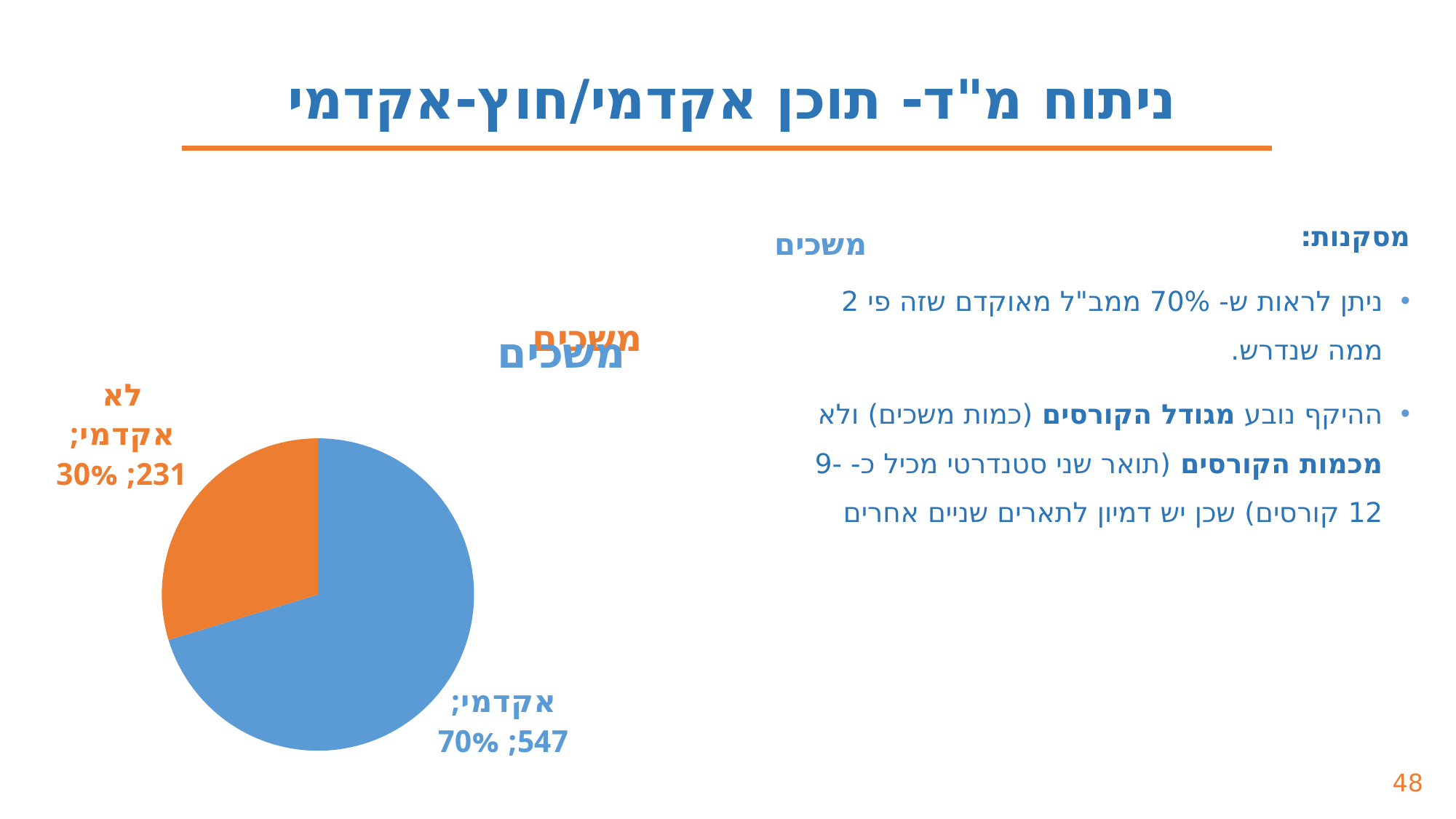
What value is shown for the לא אקדמי slice? 231 What is the difference between the אקדמי value and the לא אקדמי value? 316 What is the title of the pie chart? משכים How many slices does the pie chart have? 2 What share of the pie does the אקדמי slice represent? 70% Which is larger, the אקדמי slice or the לא אקדמי slice? אקדמי What kind of chart is shown on the slide? pie chart What share of the pie does the לא אקדמי slice represent? 30% What value is shown for the אקדמי slice? 547 What colour is the לא אקדמי slice? orange Which slice is the smallest in the pie chart? לא אקדמי Which slice is the largest in the pie chart? אקדמי